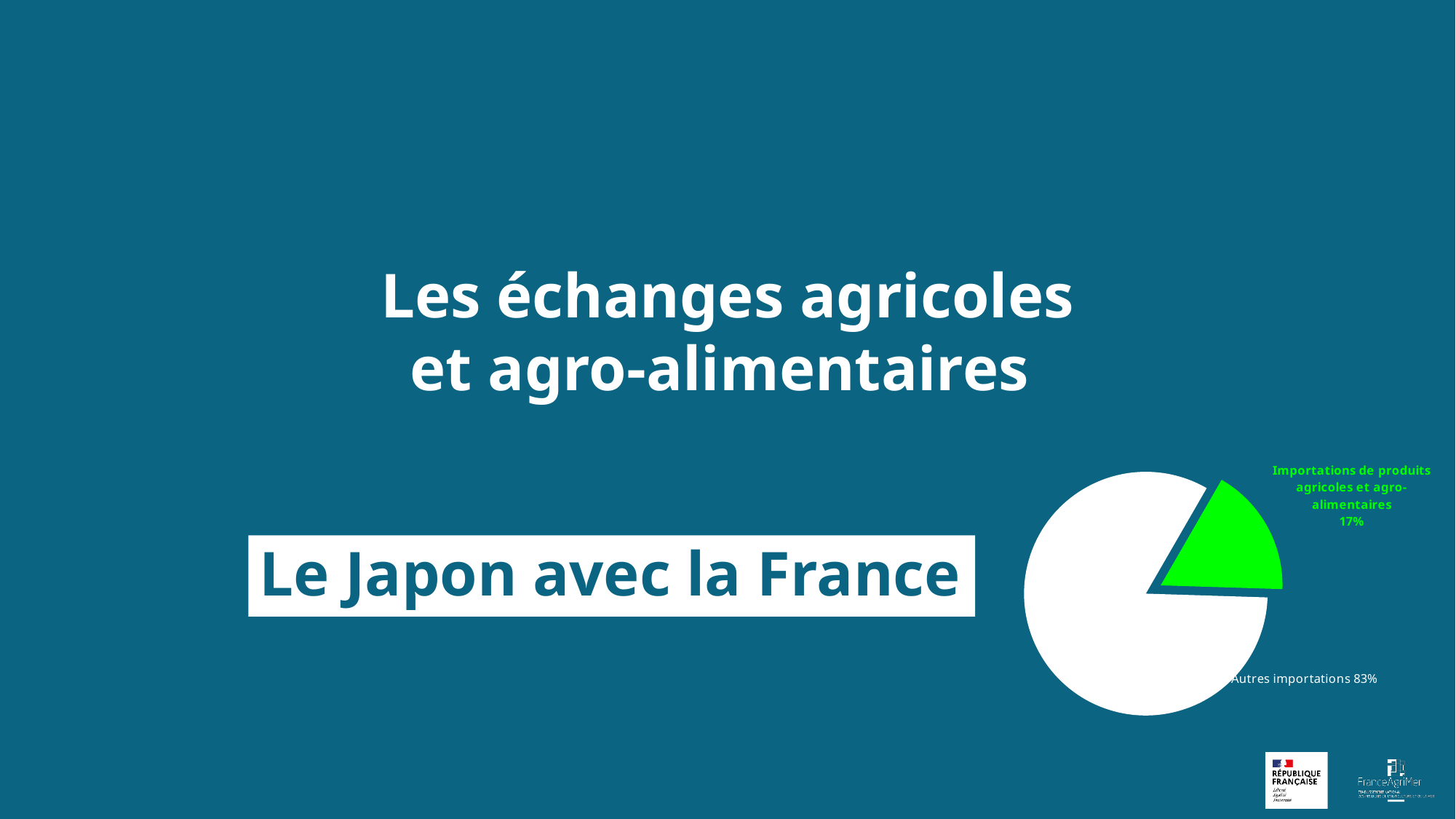
What share of the pie is labelled 'Importations de produits agricoles et agro-alimentaires'? 17% Which is larger: the share for 'Autres importations' or the share for 'Importations de produits agricoles et agro-alimentaires'? Autres importations What is the difference in percentage points between 'Autres importations' and 'Importations de produits agricoles et agro-alimentaires'? 66 Which slice of the pie is the smallest? Importations de produits agricoles et agro-alimentaires Which slice of the pie is the largest? Autres importations How many slices does the pie chart have? 2 What share of the pie is labelled 'Autres importations'? 83% What kind of chart is shown on the slide? pie chart What colour is the slice for 'Importations de produits agricoles et agro-alimentaires'? green What colour is the slice for 'Autres importations'? white